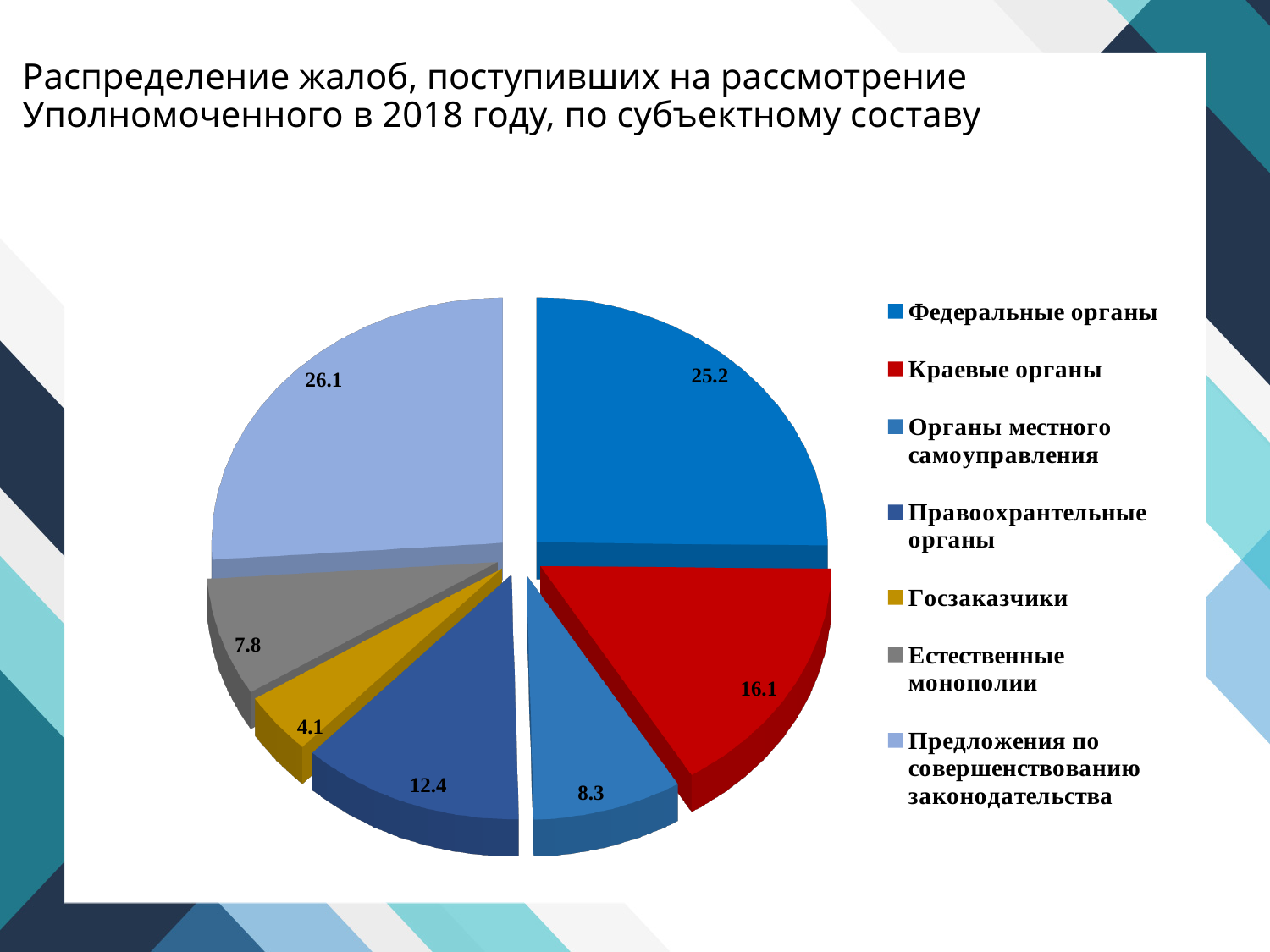
Which is larger: Краевые органы or Правоохранительные органы? Краевые органы Which category has the smallest slice? Госзаказчики How many slices does the pie chart have? 7 Which category has the largest slice? Предложения по совершенствованию законодательства What is the value for Краевые органы? 16.1 What is the difference between the values for Правоохранительные органы and Органы местного самоуправления? 4.1 How many entries does the legend list? 7 What is the value for Госзаказчики? 4.1 What kind of chart is shown on the slide? Pie chart What is the value for Федеральные органы? 25.2 What is the value for Естественные монополии? 7.8 What colour is the slice for Краевые органы? Red